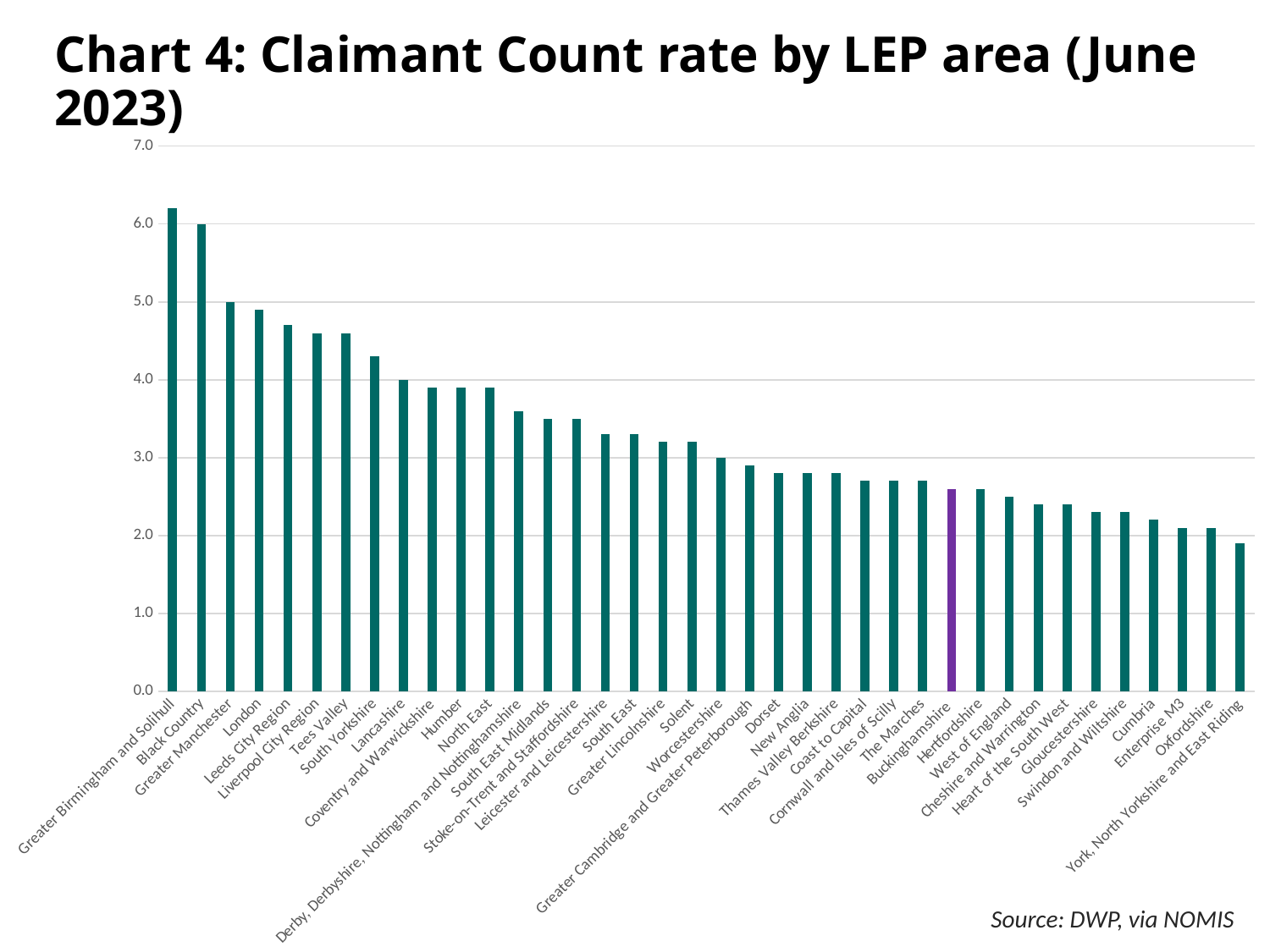
Which LEP area has the lowest Claimant Count rate? York, North Yorkshire and East Riding Is the value for Dorset greater or less than 3.0? less What kind of chart is shown on the slide? bar chart Is the value for Greater Birmingham and Solihull greater or less than 6.0? greater Which LEP area's bar is coloured purple rather than green? Buckinghamshire Is the value for Tees Valley greater or less than 4.0? greater Which LEP area has the highest Claimant Count rate? Greater Birmingham and Solihull Which has the larger Claimant Count rate, London or Dorset? London Do the values rise or fall moving from left to right along the x axis? fall What is the source cited for the chart? DWP, via NOMIS How many LEP areas are shown in the chart? 38